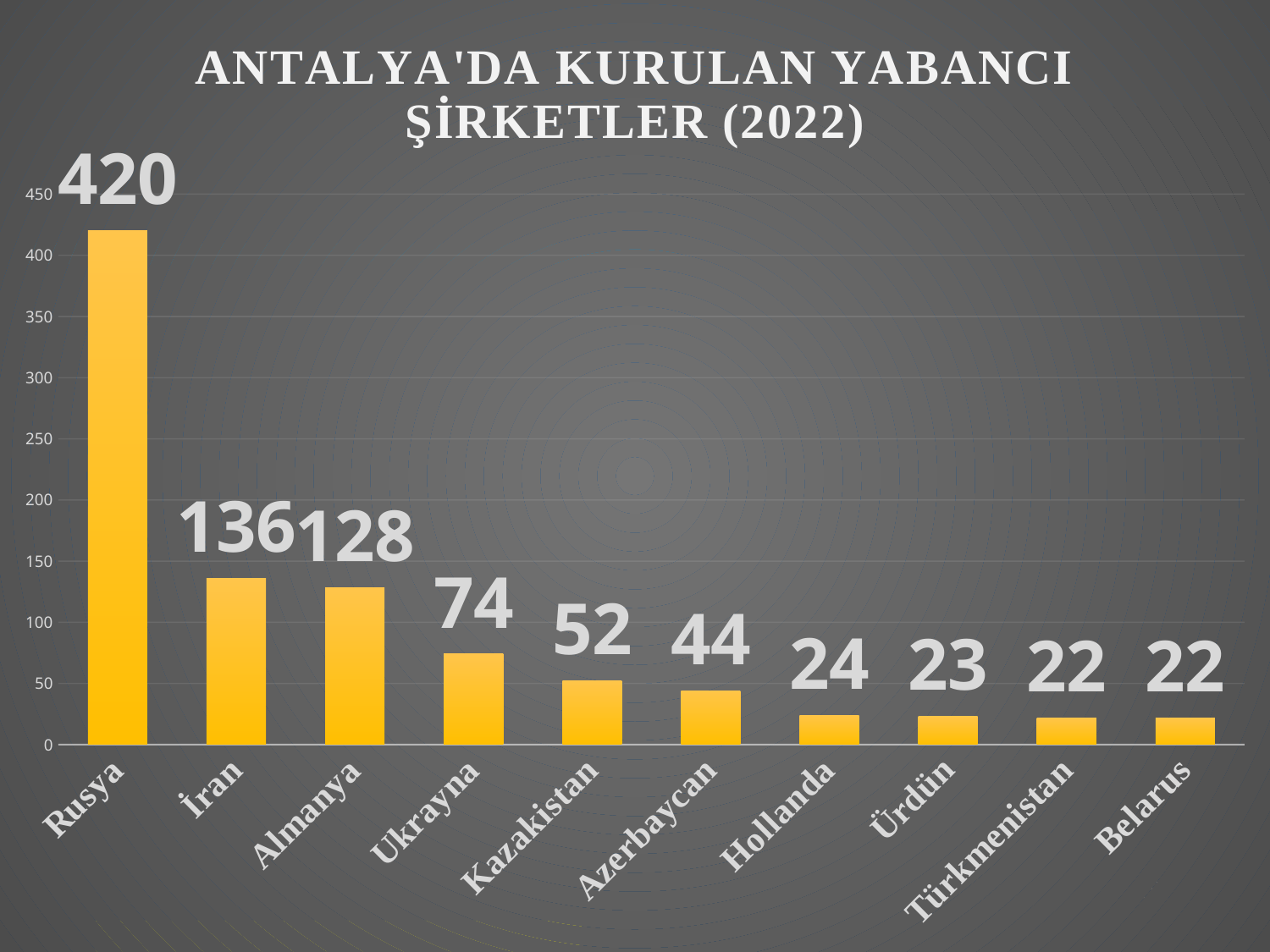
What kind of chart is shown on the slide? bar chart Is the value for Ukrayna greater or less than 100? less Which is larger, the value for Azerbaycan or the value for Hollanda? Azerbaycan What is the value for Almanya? 128 How many countries are shown on the chart? 10 Do the values rise or fall from left to right along the x axis? fall What is the value for Rusya? 420 What is the title of the chart? ANTALYA'DA KURULAN YABANCI ŞİRKETLER (2022) What is the difference between the values for Rusya and Ukrayna? 346 What is the value for Kazakistan? 52 Which country has the highest value? Rusya What is the difference between the values for İran and Almanya? 8